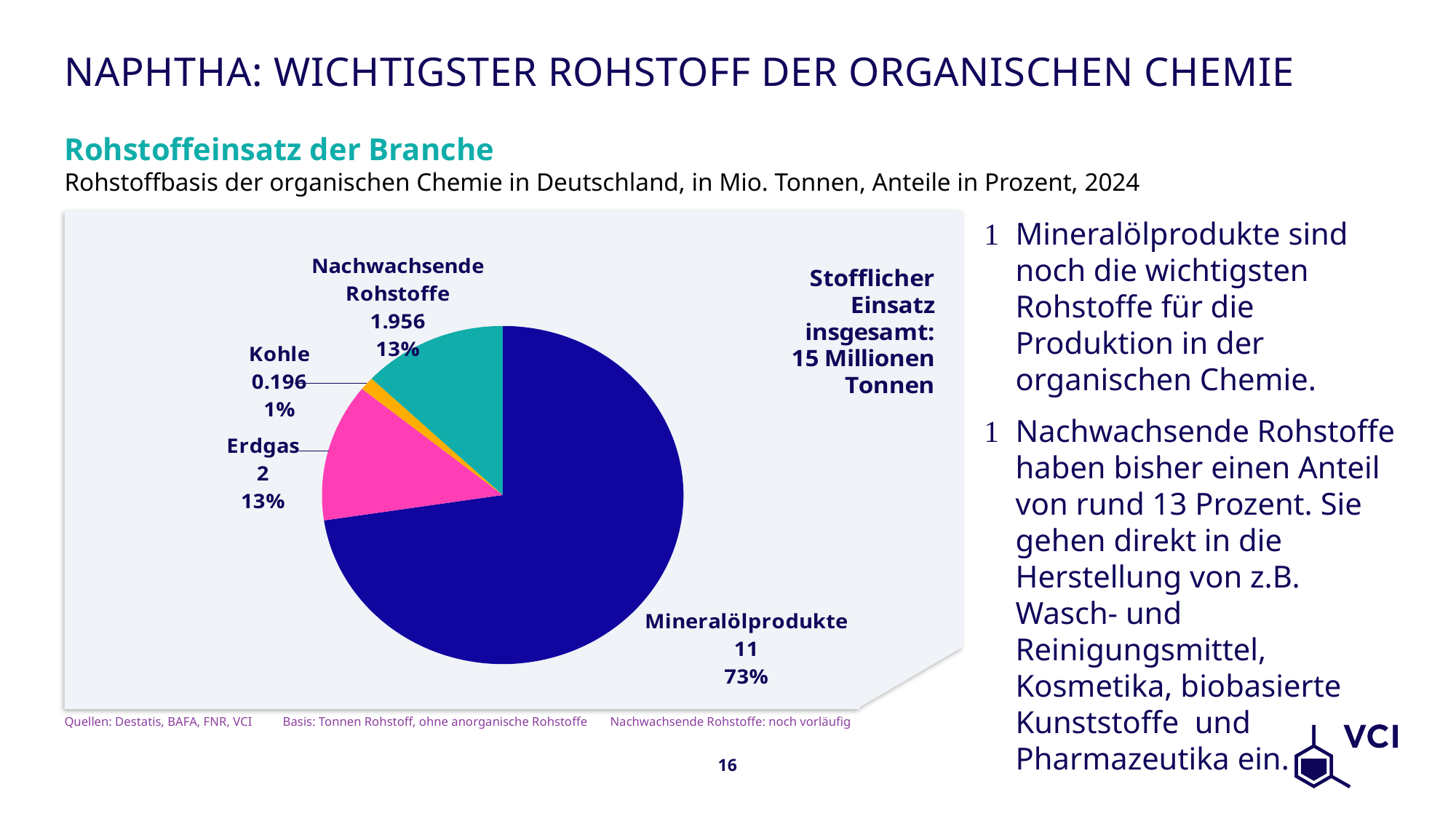
What share of the pie does Kohle account for? 1% What is the chart's title shown above the pie chart? Rohstoffeinsatz der Branche What is the value for Kohle in the pie chart? 0.196 Which category has the largest slice in the pie chart? Mineralölprodukte What is the value for Nachwachsende Rohstoffe in the pie chart? 1.956 What kind of chart is shown on the slide? pie chart What is the value for Mineralölprodukte in the pie chart? 11 What share of the pie does Mineralölprodukte account for? 73% What share of the pie does Erdgas account for? 13% Which category has the smallest slice in the pie chart? Kohle Which is larger in the pie chart, Mineralölprodukte or Erdgas? Mineralölprodukte How many slices does the pie chart have? 4